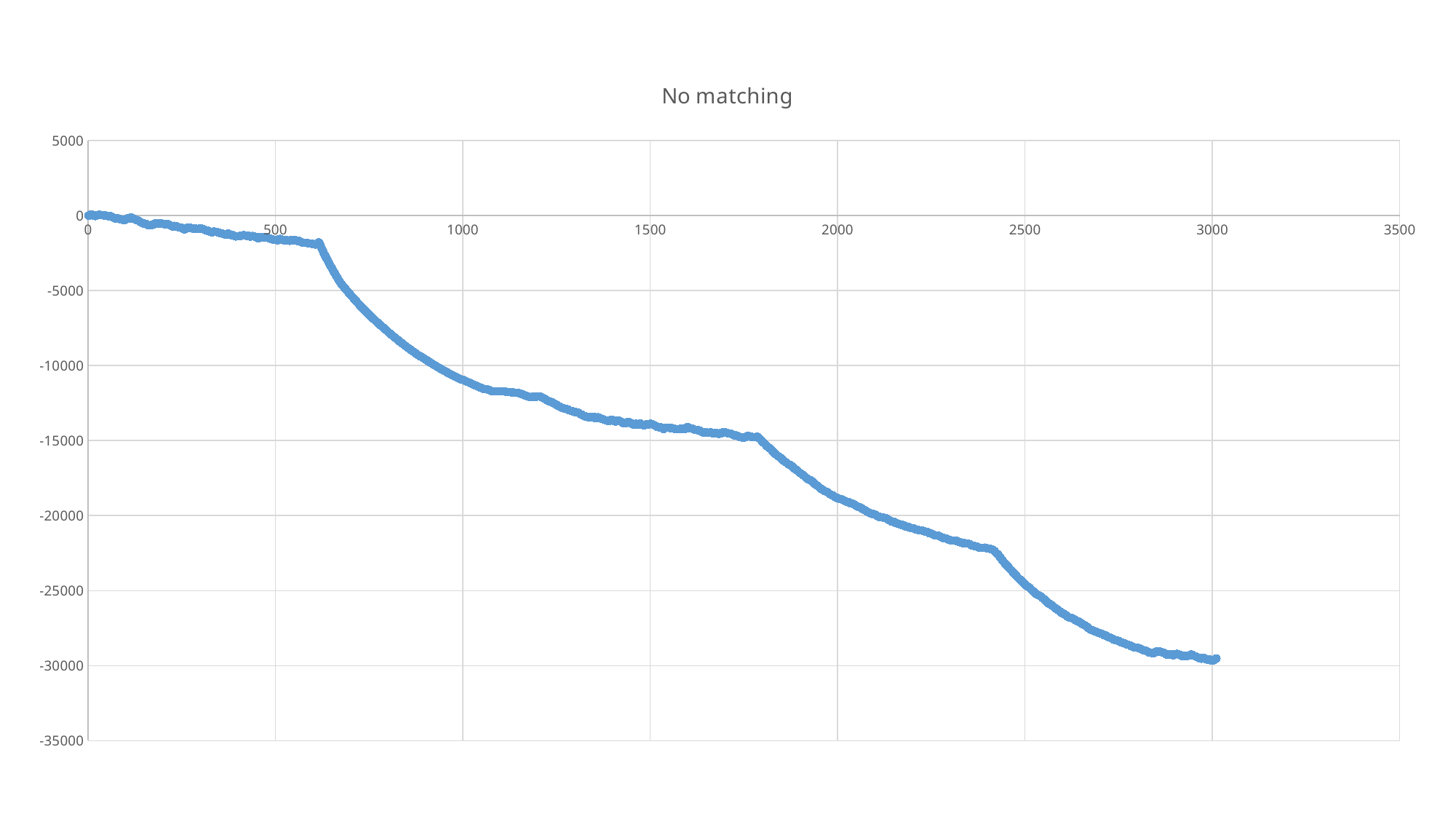
What is the largest tick label shown on the x axis? 3500 Is the value at x = 500 greater or less than -5000? greater Is the value at x = 1000 greater or less than -10000? less Is the value at x = 1500 greater or less than -15000? greater What is the title of the chart? No matching Do the plotted values rise or fall as the x axis increases from 0 to 3000? fall What kind of chart is shown on the slide? scatter chart